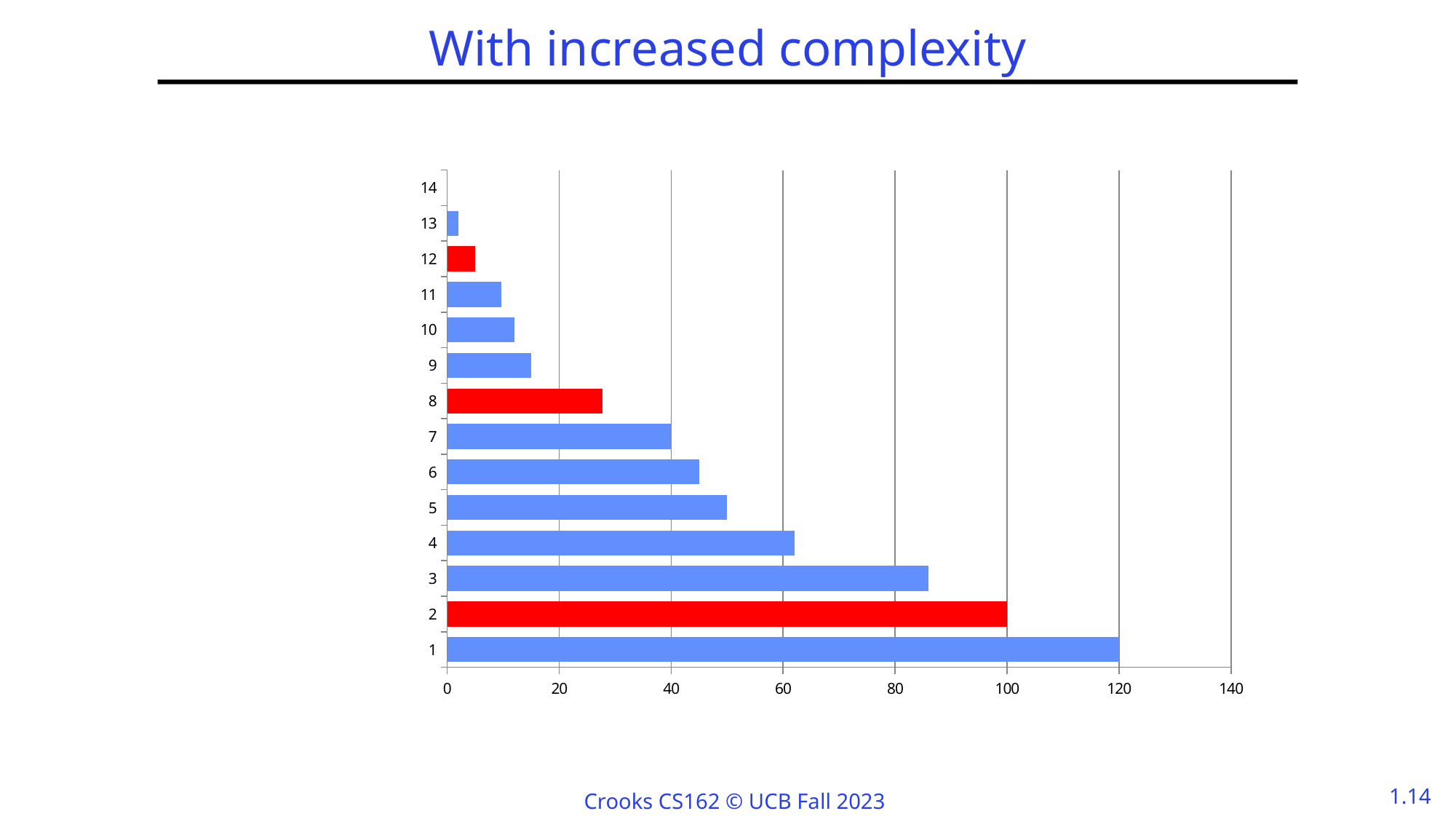
Which is larger, the value for category 5 or the value for category 6? category 5 Do the bar values rise or fall as the category number increases from 1 to 14? fall How many categories are plotted on the chart? 14 Which category has the highest value? 1 Is the value for category 4 greater or less than 60? greater What is the value for category 1? 120 Is the value for category 8 greater or less than 40? less Is the value for category 3 greater or less than 80? greater What is the value for category 2? 100 Which categories are drawn with red bars? 2, 8 and 12 What is the value for category 7? 40 What kind of chart is shown on the slide? bar chart